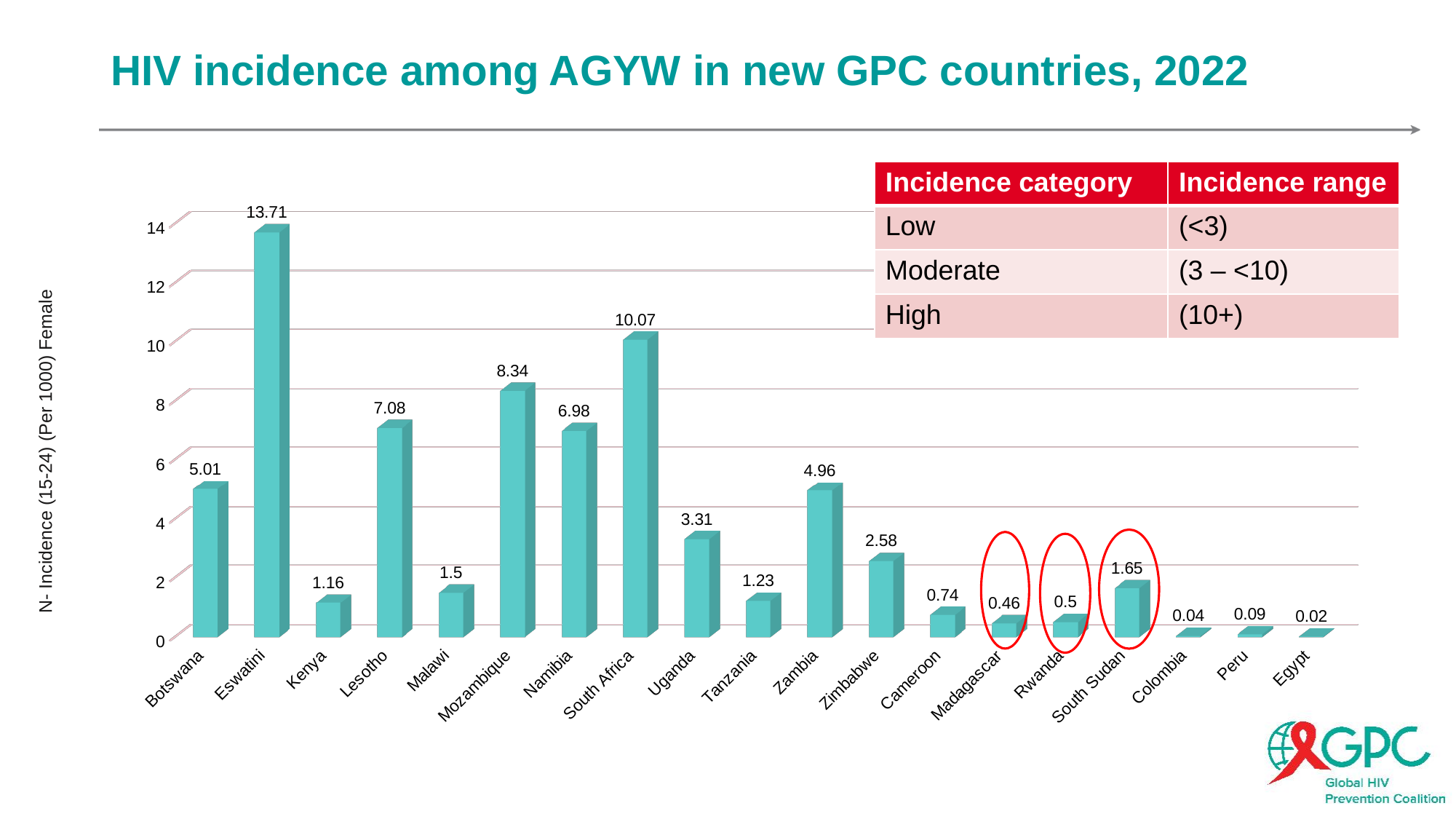
What is the HIV incidence value shown for South Sudan? 1.65 What is the difference between the values for Mozambique and Namibia? 1.36 What is the HIV incidence value shown for South Africa? 10.07 Which country has the highest HIV incidence in the chart? Eswatini What is the y-axis label of the chart? N- Incidence (15-24) (Per 1000) Female What is the HIV incidence value shown for Eswatini? 13.71 Which country has the lowest HIV incidence in the chart? Egypt What type of chart is shown on the slide? Bar chart How many countries are shown on the x axis of the chart? 19 What is the difference between the values for Eswatini and South Africa? 3.64 What is the HIV incidence value shown for Zambia? 4.96 Which has a higher HIV incidence, Lesotho or Botswana? Lesotho